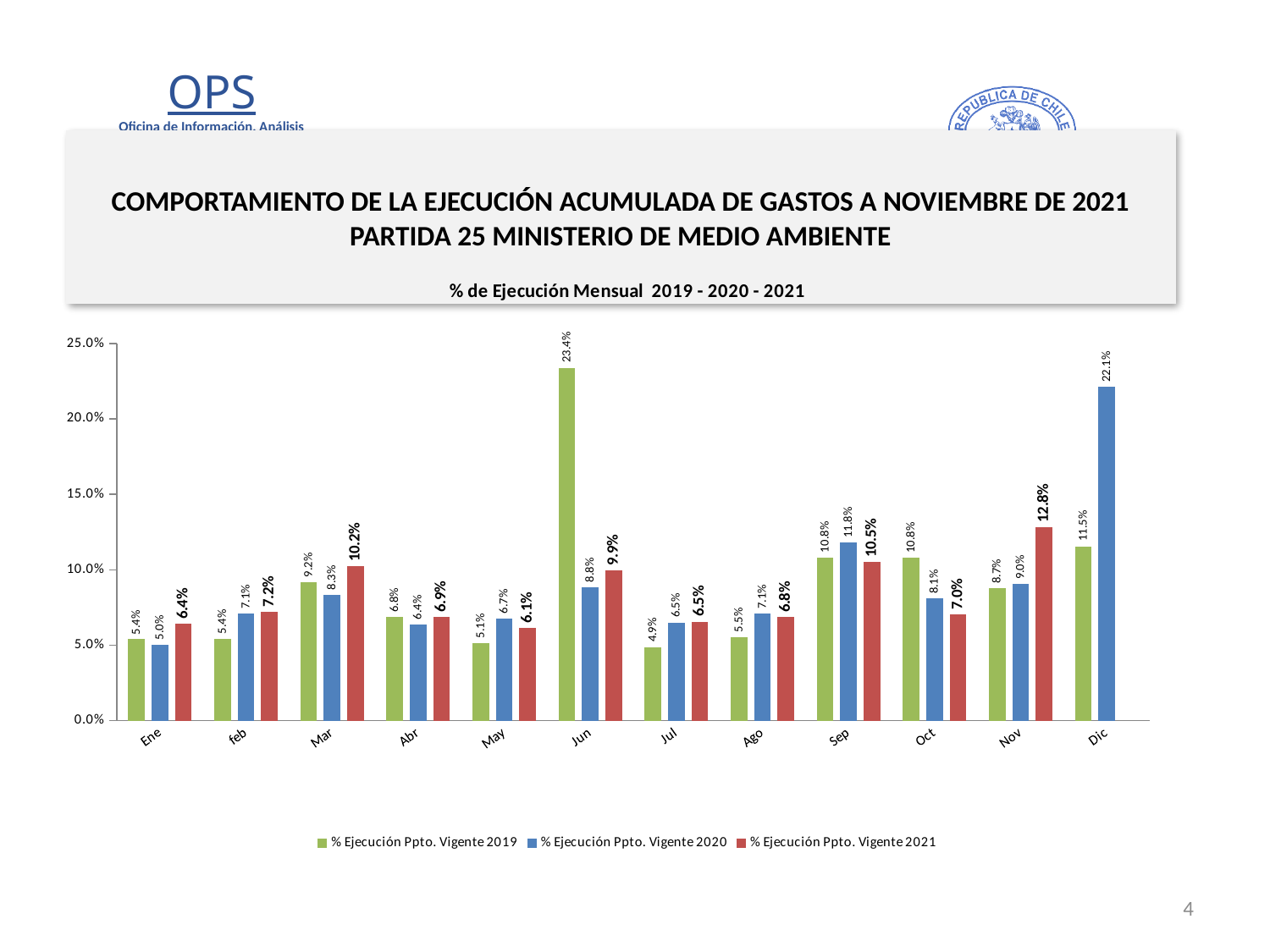
In which month is the % Ejecución Ppto. Vigente 2019 series lowest? Jul How many series does the legend list? 3 In which month is the % Ejecución Ppto. Vigente 2021 series highest? Nov What is the value for % Ejecución Ppto. Vigente 2019 in Jun? 23.4% Which is larger in Sep: the 2020 value or the 2021 value? 2020 value (11.8%) What kind of chart is shown on the slide? Bar chart How many months are shown on the x axis? 12 What is the value for % Ejecución Ppto. Vigente 2021 in Nov? 12.8% Is the value for % Ejecución Ppto. Vigente 2019 in Jun greater or less than 20.0%? greater What is the value for % Ejecución Ppto. Vigente 2021 in Mar? 10.2% What is the value for % Ejecución Ppto. Vigente 2020 in Dic? 22.1% What is the difference between the 2020 and 2019 values in Dic? 10.6%